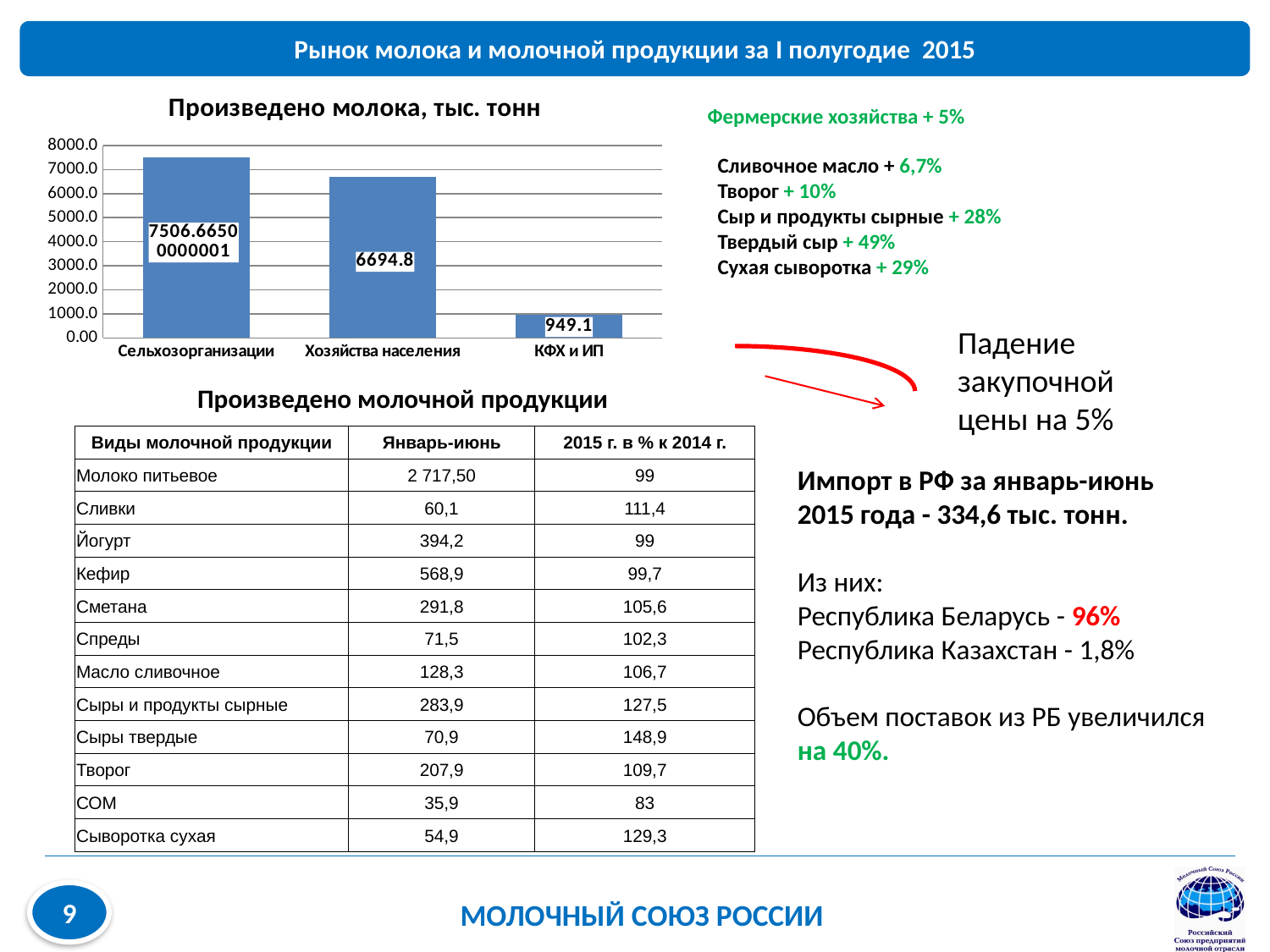
In the chart 'Произведено молока, тыс. тонн', which category has the lowest value? КФХ и ИП What type of chart is shown under the title 'Произведено молока, тыс. тонн'? bar chart What is the title of the bar chart on the slide? Произведено молока, тыс. тонн In the chart 'Произведено молока, тыс. тонн', what is the value for Хозяйства населения? 6694.8 In the chart 'Произведено молока, тыс. тонн', what is the difference between the values for Хозяйства населения and КФХ и ИП? 5745.7 In the chart 'Произведено молока, тыс. тонн', which is larger: the value for Сельхозорганизации or the value for Хозяйства населения? Сельхозорганизации In the chart 'Произведено молока, тыс. тонн', which category has the highest value? Сельхозорганизации In the chart 'Произведено молока, тыс. тонн', is the value for Сельхозорганизации greater or less than 7000.0? greater In the chart 'Произведено молока, тыс. тонн', is the value for КФХ и ИП greater or less than 1000.0? less In the chart 'Произведено молока, тыс. тонн', what is the value for КФХ и ИП? 949.1 In the chart 'Произведено молока, тыс. тонн', do the values rise or fall from left to right along the x axis? fall How many categories are shown in the chart 'Произведено молока, тыс. тонн'? 3